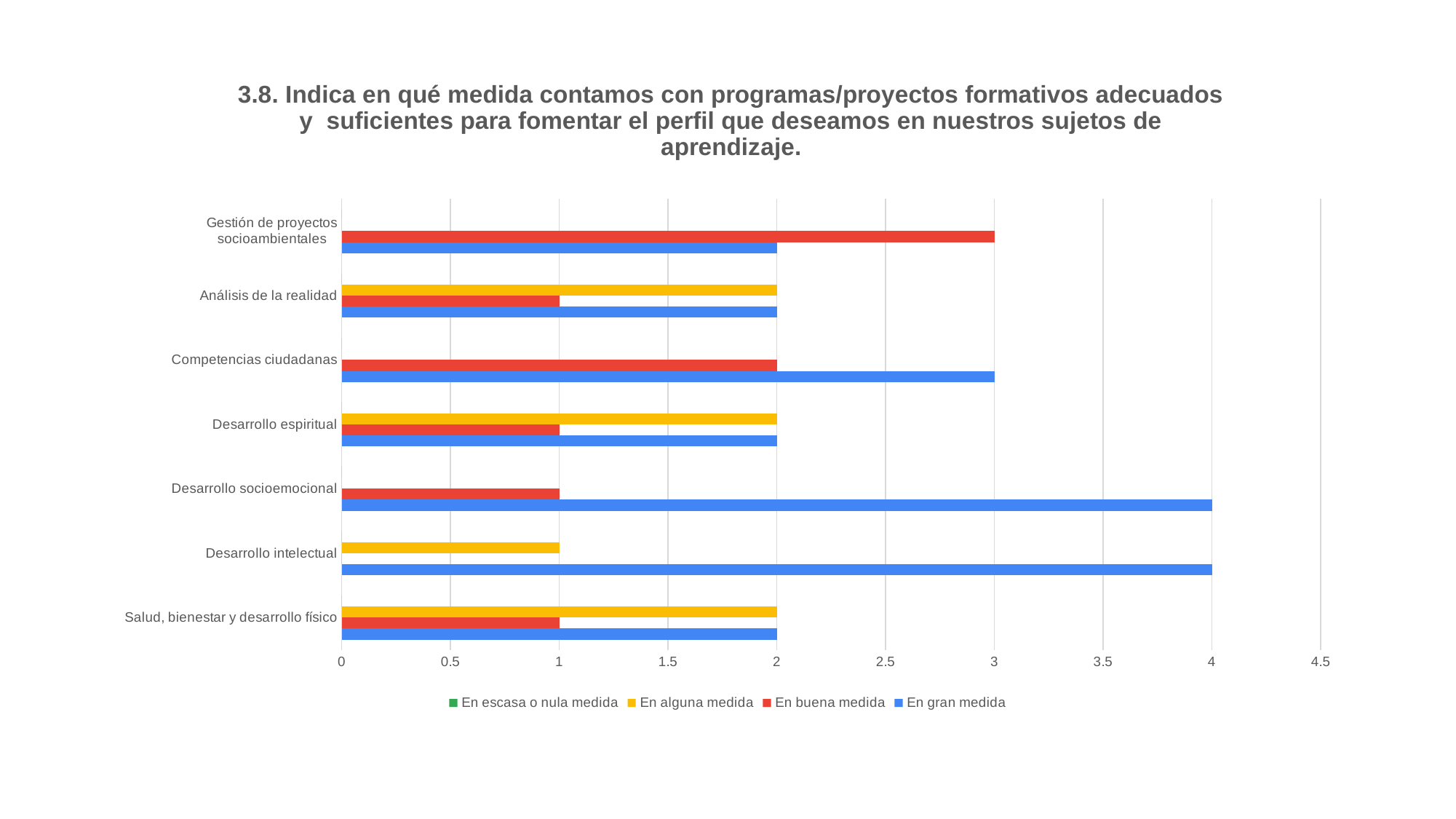
Is the value of "En gran medida" for Desarrollo socioemocional greater or less than 3? greater Which category has the highest value for "En buena medida"? Gestión de proyectos socioambientales How many categories are shown on the vertical axis of the chart? 7 For Competencias ciudadanas, which is larger: "En buena medida" or "En gran medida"? En gran medida What is the difference between "En gran medida" for Desarrollo intelectual and "En gran medida" for Análisis de la realidad? 2 What is the value of "En buena medida" for Gestión de proyectos socioambientales? 3 How many series does the legend list? 4 What is the value of "En gran medida" for Desarrollo socioemocional? 4 Which legend entry is shown in green? En escasa o nula medida What is the value of "En gran medida" for Competencias ciudadanas? 3 What kind of chart is shown on the slide? Bar chart What is the value of "En alguna medida" for Desarrollo intelectual? 1